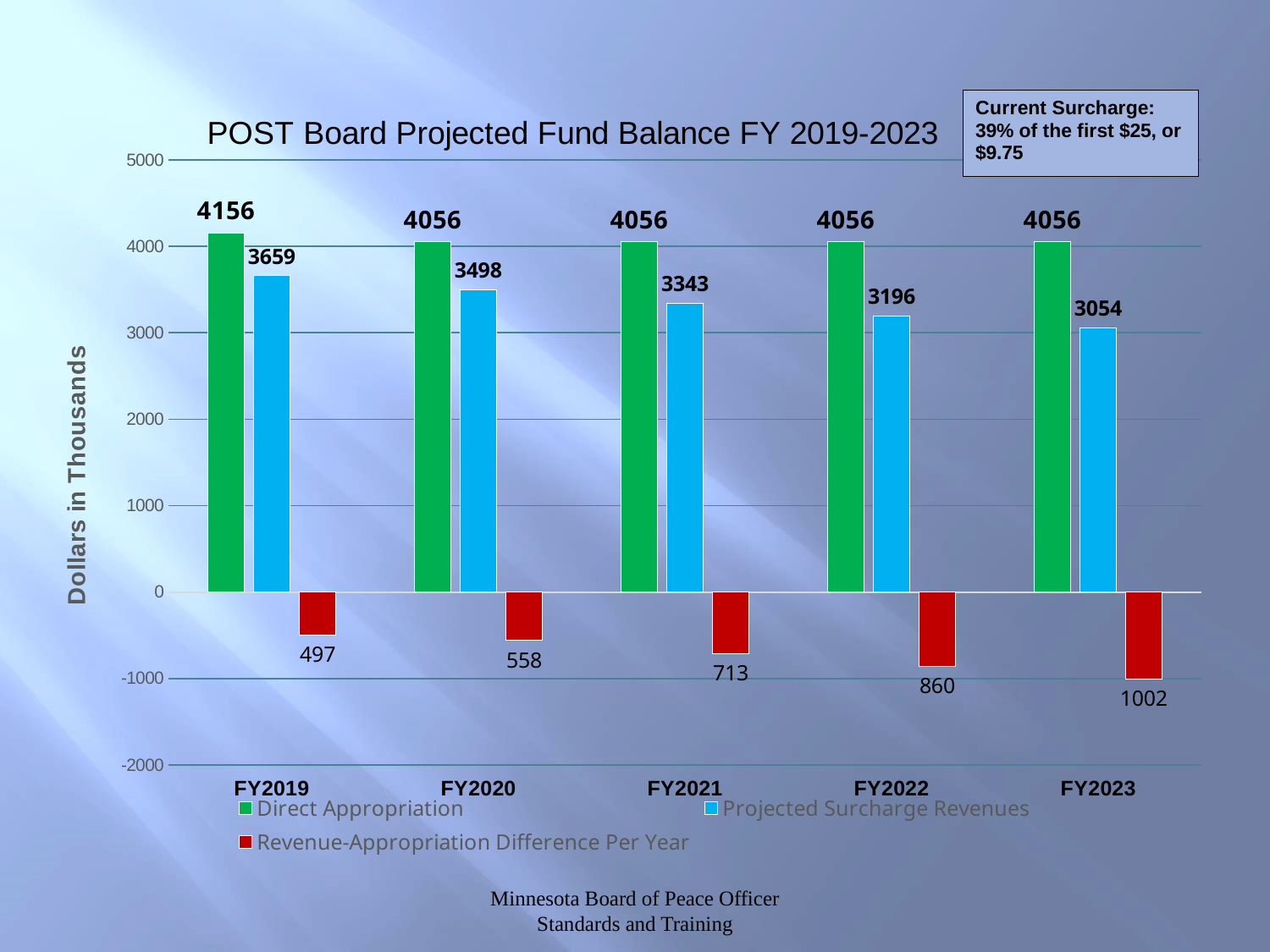
How many series does the legend list? 3 How many fiscal years are shown on the x axis? 5 What kind of chart is shown on the slide? Bar chart What is the difference between Direct Appropriation and Projected Surcharge Revenues in FY2020? 558 What is the data label on the Revenue-Appropriation Difference Per Year bar for FY2022? 860 Which is larger in FY2022, Direct Appropriation or Projected Surcharge Revenues? Direct Appropriation Which fiscal year has the lowest Projected Surcharge Revenues? FY2023 Do the Projected Surcharge Revenues rise or fall from FY2019 to FY2023? Fall What is the Projected Surcharge Revenues value for FY2023? 3054 What is the Projected Surcharge Revenues value for FY2021? 3343 Which fiscal year has the highest Projected Surcharge Revenues? FY2019 What is the Direct Appropriation value for FY2019? 4156